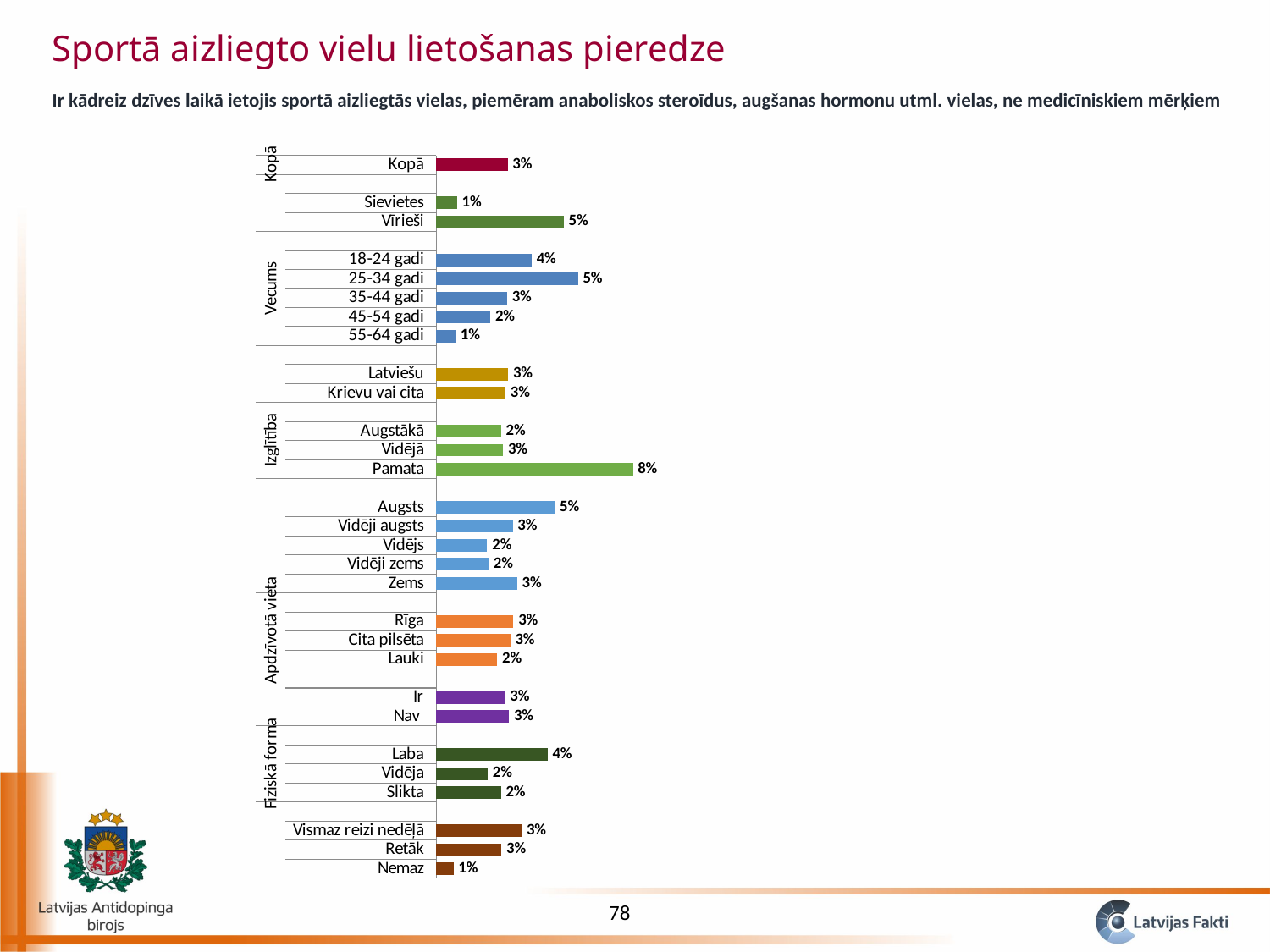
Which category has the highest value in the chart? Pamata Do the values rise or fall going from 25-34 gadi down to 55-64 gadi? Fall Which age group (gadi) has the lowest value? 55-64 gadi What is the difference between the values for Pamata and Augstākā? 6% What is the value for Kopā? 3% What is the value for Sievietes? 1% What is the value for 25-34 gadi? 5% What is the value for Pamata? 8% Which is larger, the value for Laba or the value for Slikta? Laba Which is larger, the value for Augsts or the value for Vidējs? Augsts What is the difference between the values for Vīrieši and Sievietes? 4% What kind of chart is shown on the slide? Bar chart